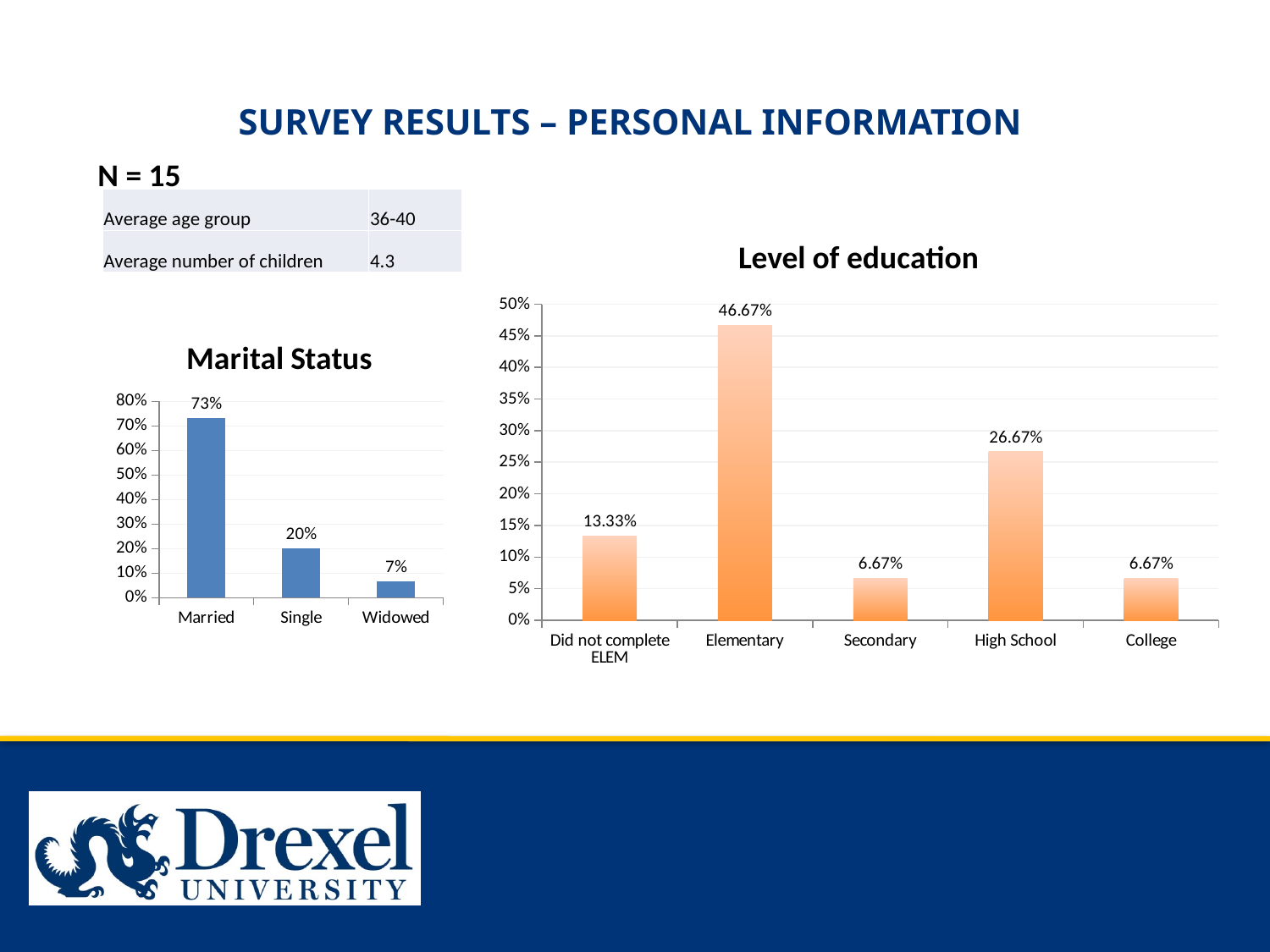
In the Level of education chart, what is the value for High School? 26.67% In the Level of education chart, what is the difference between the values for Elementary and High School? 20% What kind of chart is the Level of education chart? Bar chart In the Level of education chart, which category has the highest value? Elementary In the Level of education chart, which is larger, the value for Did not complete ELEM or the value for Secondary? Did not complete ELEM In the Marital Status chart, do the values rise or fall from Married to Widowed? Fall In the Level of education chart, what is the value for Did not complete ELEM? 13.33% In the Marital Status chart, how many categories are shown? 3 In the Marital Status chart, what is the value for Married? 73% In the Level of education chart, how many categories are shown? 5 In the Marital Status chart, what is the difference between the values for Married and Single? 53% In the Marital Status chart, which category has the lowest value? Widowed